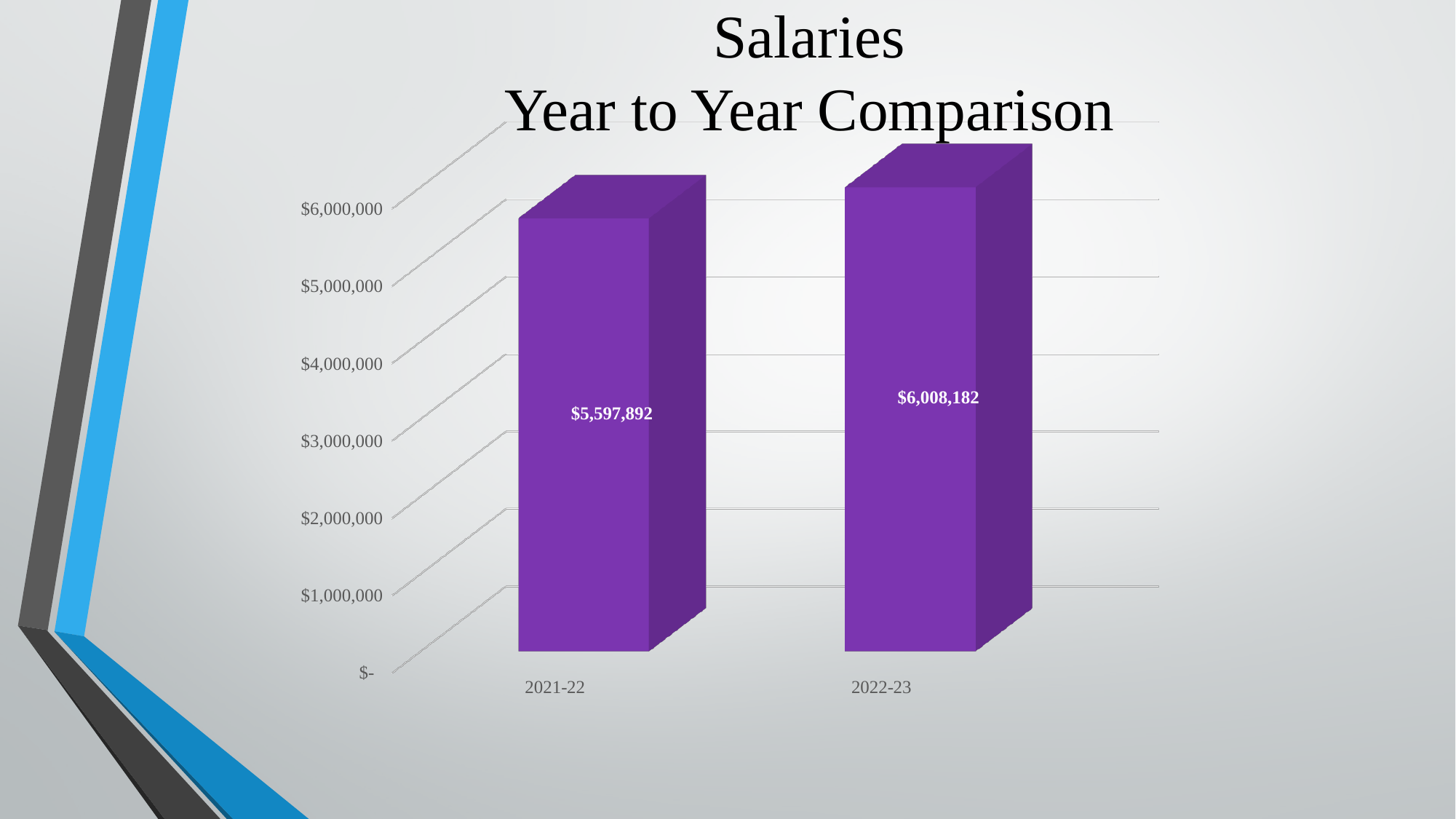
What is the salary value for 2021-22? $5,597,892 Is the salary value for 2021-22 larger or smaller than the value for 2022-23? smaller What is the difference between the 2022-23 and 2021-22 salary values? $410,290 Is the value for 2022-23 greater or less than $6,000,000? greater Which year has the higher salary value? 2022-23 What is the salary value for 2022-23? $6,008,182 What kind of chart is shown on the slide? bar chart Do the salary values rise or fall from 2021-22 to 2022-23? rise Is the value for 2021-22 greater or less than $6,000,000? less Which year has the lower salary value? 2021-22 What is the title of the chart? Salaries Year to Year Comparison How many years are shown on the chart? 2